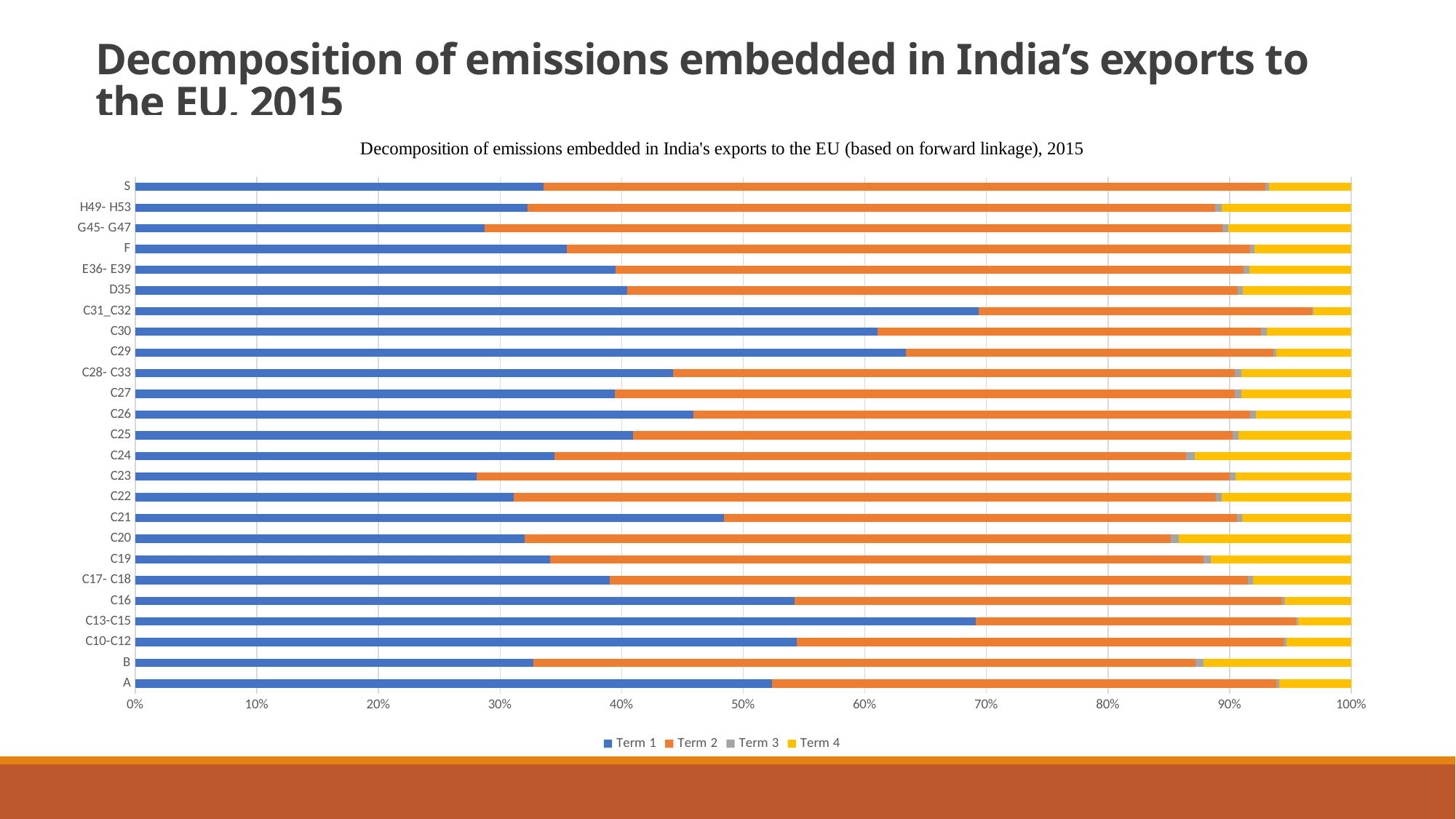
What is the title of the chart? Decomposition of emissions embedded in India's exports to the EU (based on forward linkage), 2015 How many categories are plotted on the vertical axis? 25 Which series is shown in yellow in the legend? Term 4 What does each stacked bar total on the horizontal axis? 100% What kind of chart is shown on the slide? bar chart Is the Term 1 value for C23 greater or less than 30%? less Which has the larger Term 1 share, C31_C32 or C23? C31_C32 How many series does the legend list? 4 Is the Term 1 value for A greater or less than 50%? greater Is the Term 1 value for G45- G47 greater or less than 30%? less Which has the larger Term 1 share, A or B? A